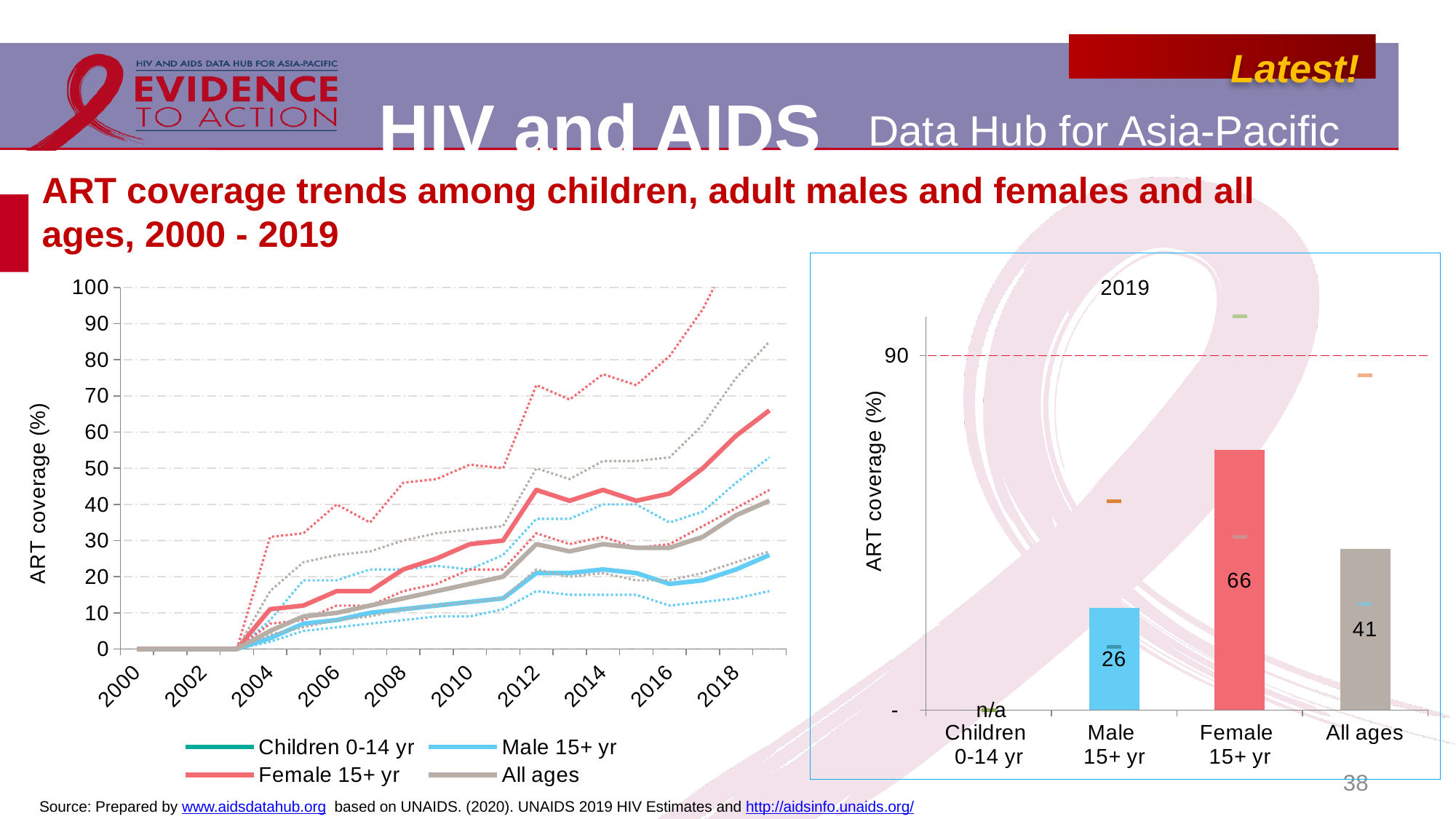
In the 2019 bar chart on the right, what is the difference between the Female 15+ yr and All ages values? 25 In the 2019 bar chart on the right, what is the ART coverage value for Male 15+ yr? 26 In the 2019 bar chart on the right, which category has the highest ART coverage? Female 15+ yr In the 2019 bar chart on the right, what is the ART coverage value for All ages? 41 In the line chart on the left, does the Female 15+ yr solid line rise or fall from 2004 to 2019? rise What kind of chart is the chart on the right of the slide (2019)? bar chart In the 2019 bar chart on the right, what is the ART coverage value for Female 15+ yr? 66 In the 2019 bar chart on the right, which is larger: the value for Male 15+ yr or for All ages? All ages In the line chart on the left, is the solid Male 15+ yr value in 2016 greater or less than 30? less In the 2019 bar chart on the right, what label is shown for Children 0-14 yr? n/a How many series does the legend of the line chart on the left list? 4 In the 2019 bar chart on the right, what is the difference between the Female 15+ yr and Male 15+ yr values? 40